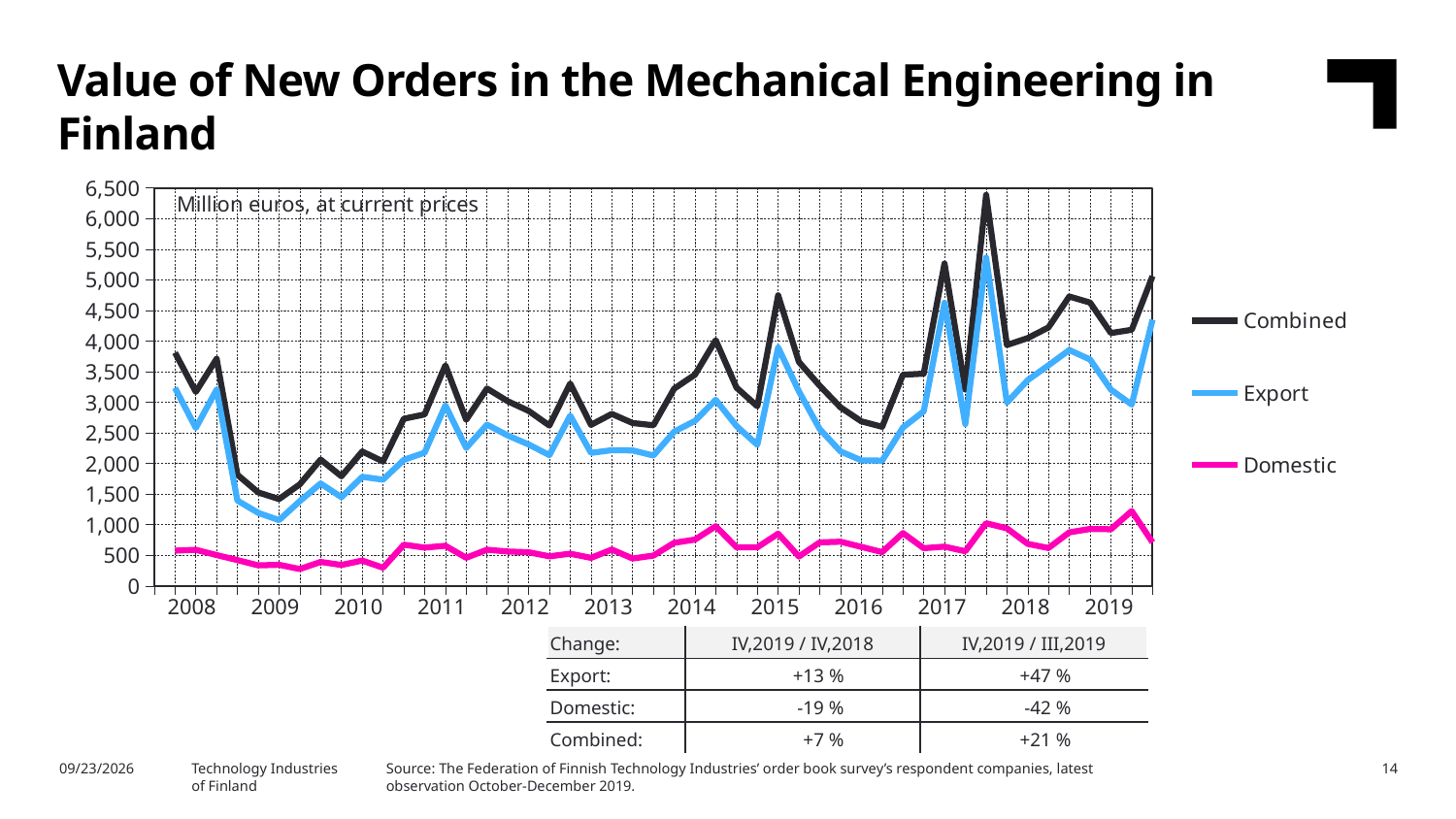
Which series are listed in the chart legend? Combined, Export, Domestic Which series has the lowest values throughout the period, Export or Domestic? Domestic Is the peak value of the Combined series in 2017 greater or less than 6,000? greater Is the Domestic series ever greater or less than 1,500 across the whole period? less Does the Combined series rise or fall from its 2009 low to 2011? Rise How many year labels are shown on the x axis? 12 What kind of chart is shown on the slide? Line chart Which series reaches the highest value on the chart? Combined Is the first Combined value in 2008 greater or less than 3,500? greater How many series does the legend list? 3 What unit is stated in the label inside the chart area? Million euros, at current prices